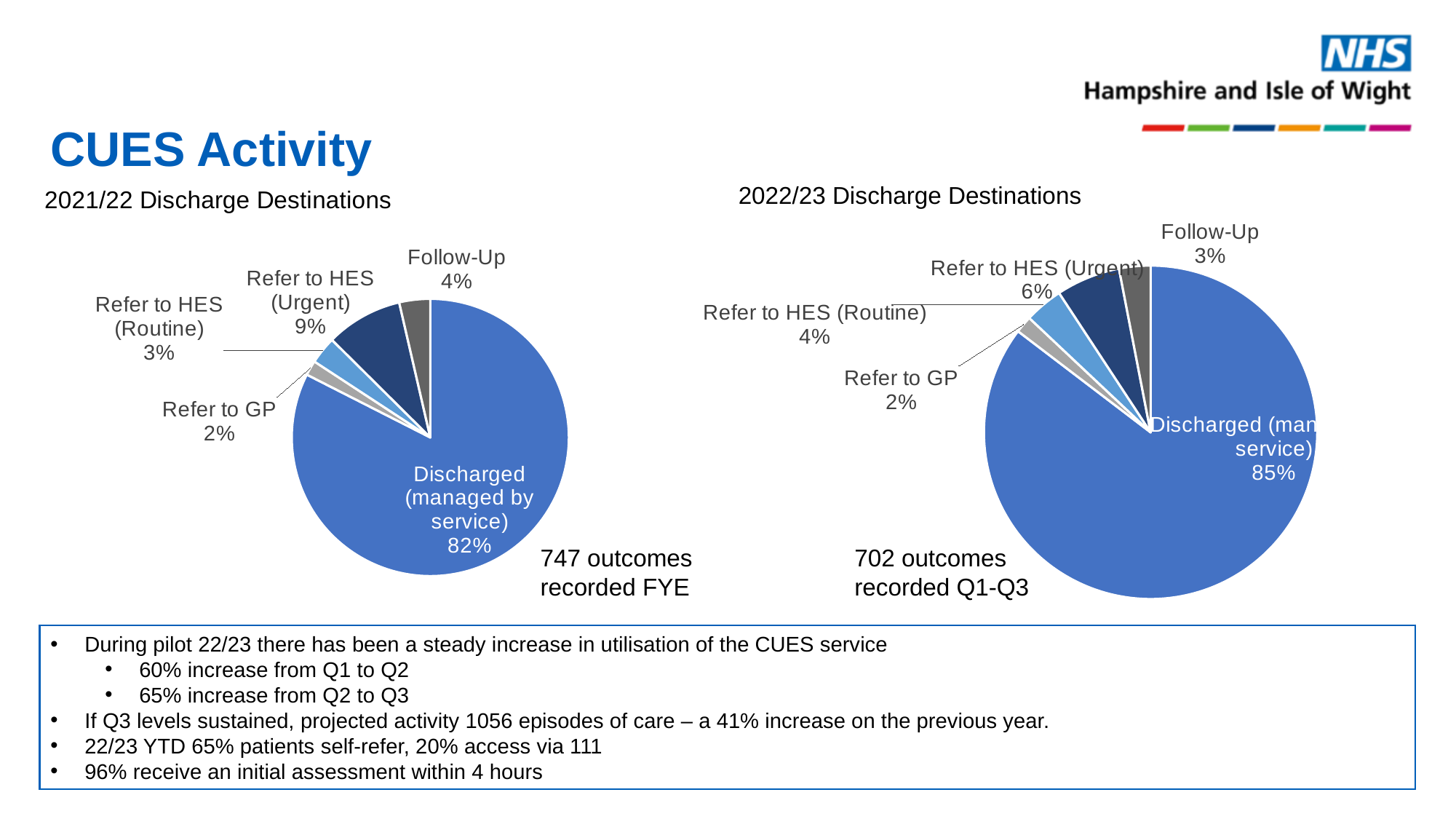
In the 2021/22 Discharge Destinations chart, what share is Discharged (managed by service)? 82% In the 2022/23 Discharge Destinations chart, what share is Discharged (managed by service)? 85% How many categories are shown in the 2021/22 Discharge Destinations chart? 5 In the 2022/23 Discharge Destinations chart, what share is Refer to HES (Routine)? 4% In the 2021/22 Discharge Destinations chart, what share is Refer to HES (Urgent)? 9% In the 2021/22 Discharge Destinations chart, what share is Follow-Up? 4% In the 2021/22 Discharge Destinations chart, which category has the smallest share? Refer to GP What type of chart is used for the 2022/23 Discharge Destinations? Pie chart What is the difference between the Refer to HES (Urgent) share in 2021/22 and in 2022/23? 3% In the 2022/23 Discharge Destinations chart, what share is Refer to HES (Urgent)? 6% Which is larger in the 2022/23 Discharge Destinations chart: Refer to HES (Urgent) or Follow-Up? Refer to HES (Urgent) In the 2022/23 Discharge Destinations chart, which category has the largest share? Discharged (managed by service)